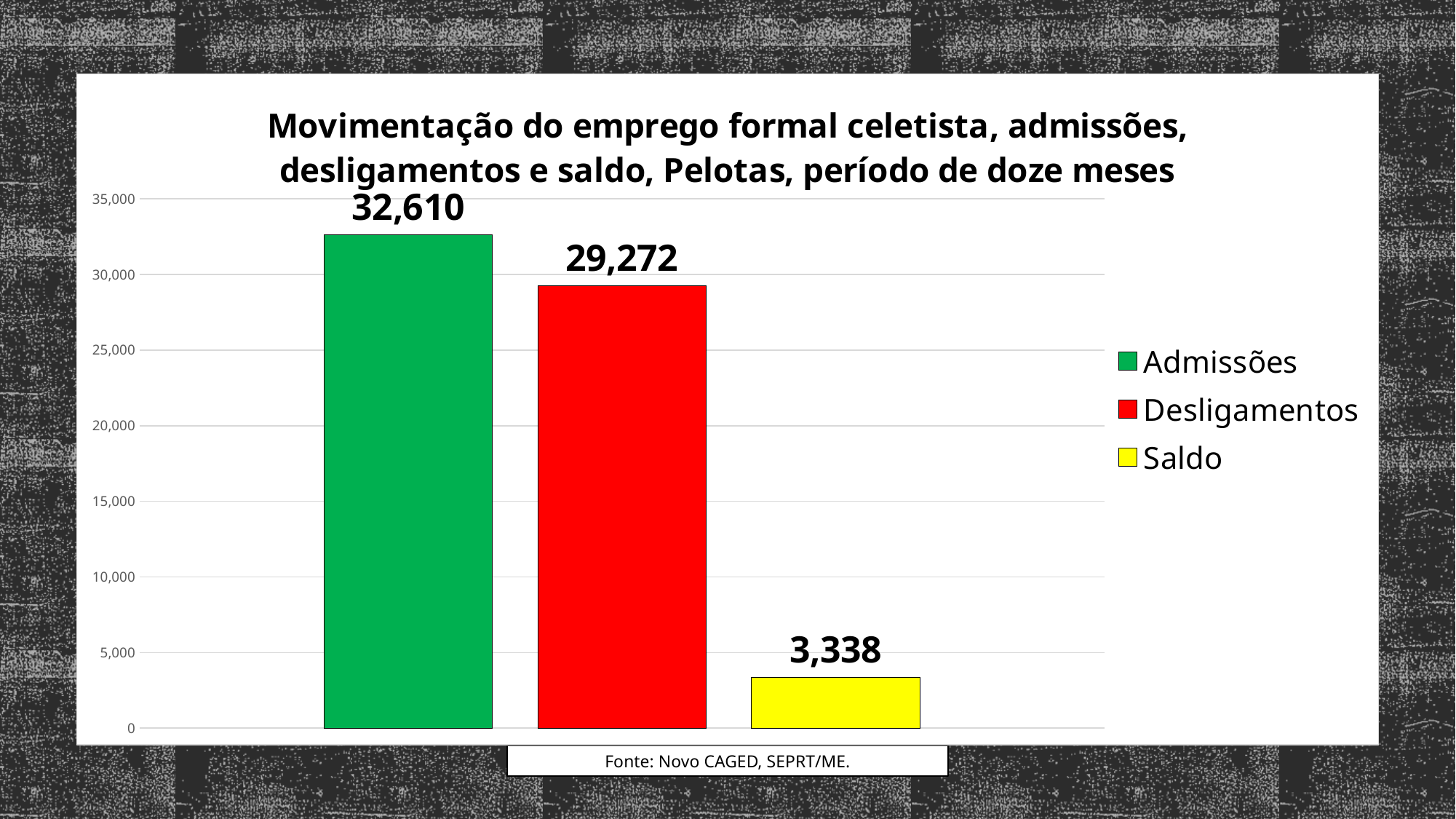
What is the value for Saldo? 3,338 What is the value for Admissões? 32,610 Which is larger, Admissões or Desligamentos? Admissões What is the difference between Desligamentos and Saldo? 25,934 Which series has the highest value? Admissões Is the value for Desligamentos greater or less than 30,000? less How many series does the legend list? 3 What is the value for Desligamentos? 29,272 Which series has the lowest value? Saldo What kind of chart is shown? bar chart What colour is the bar for Saldo? yellow What is the difference between Admissões and Desligamentos? 3,338